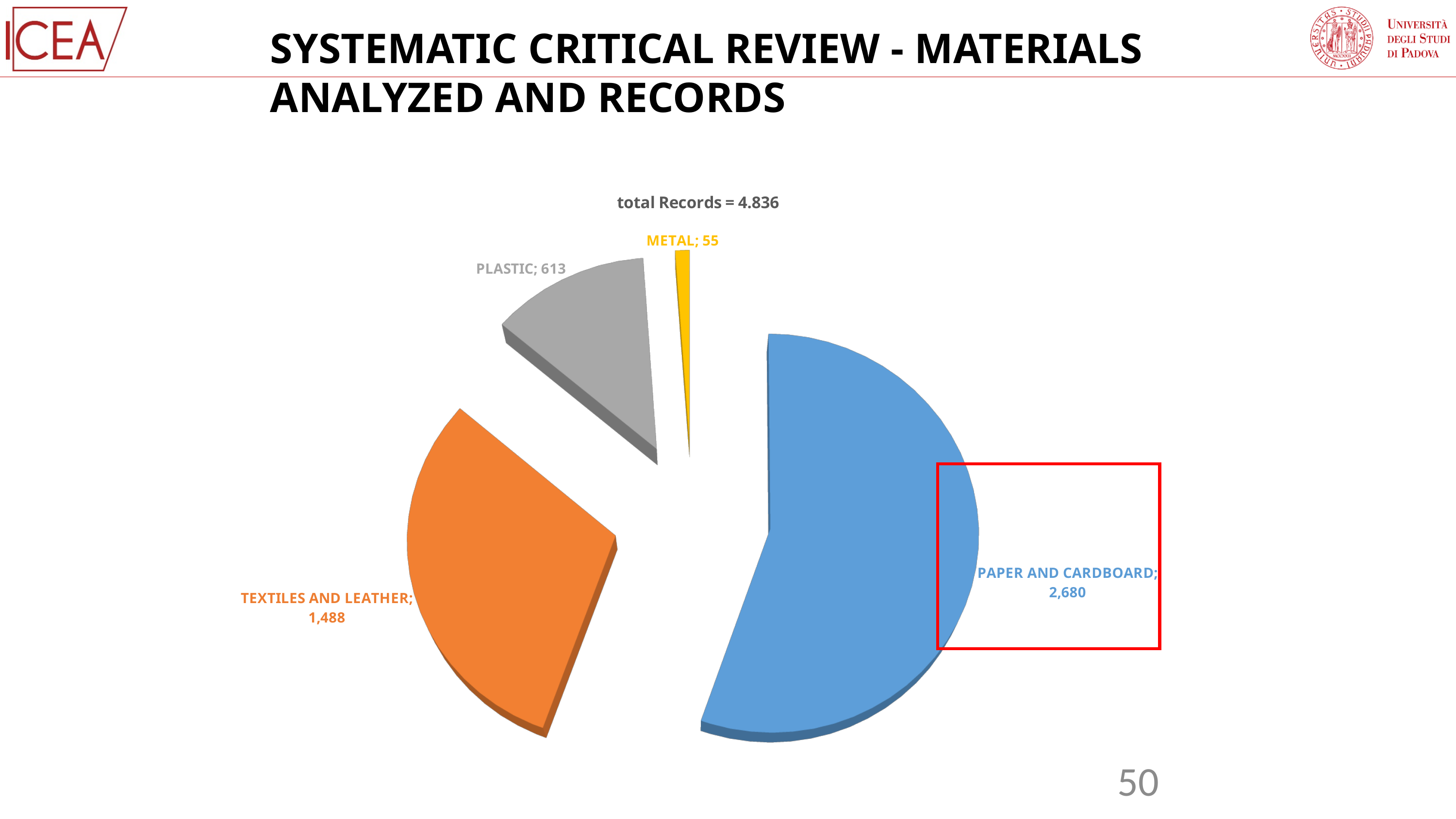
How many records are there for TEXTILES AND LEATHER? 1,488 How many records are there for PAPER AND CARDBOARD? 2,680 How many slices does the pie chart have? 4 Which material has the largest number of records? PAPER AND CARDBOARD What colour is the PAPER AND CARDBOARD slice? Blue What total number of records is stated in the chart title? 4.836 How many records are there for METAL? 55 Which has more records, PLASTIC or METAL? PLASTIC Which material has the smallest number of records? METAL What is the difference in records between PAPER AND CARDBOARD and TEXTILES AND LEATHER? 1,192 How many records are there for PLASTIC? 613 What type of chart is shown on the slide? Pie chart